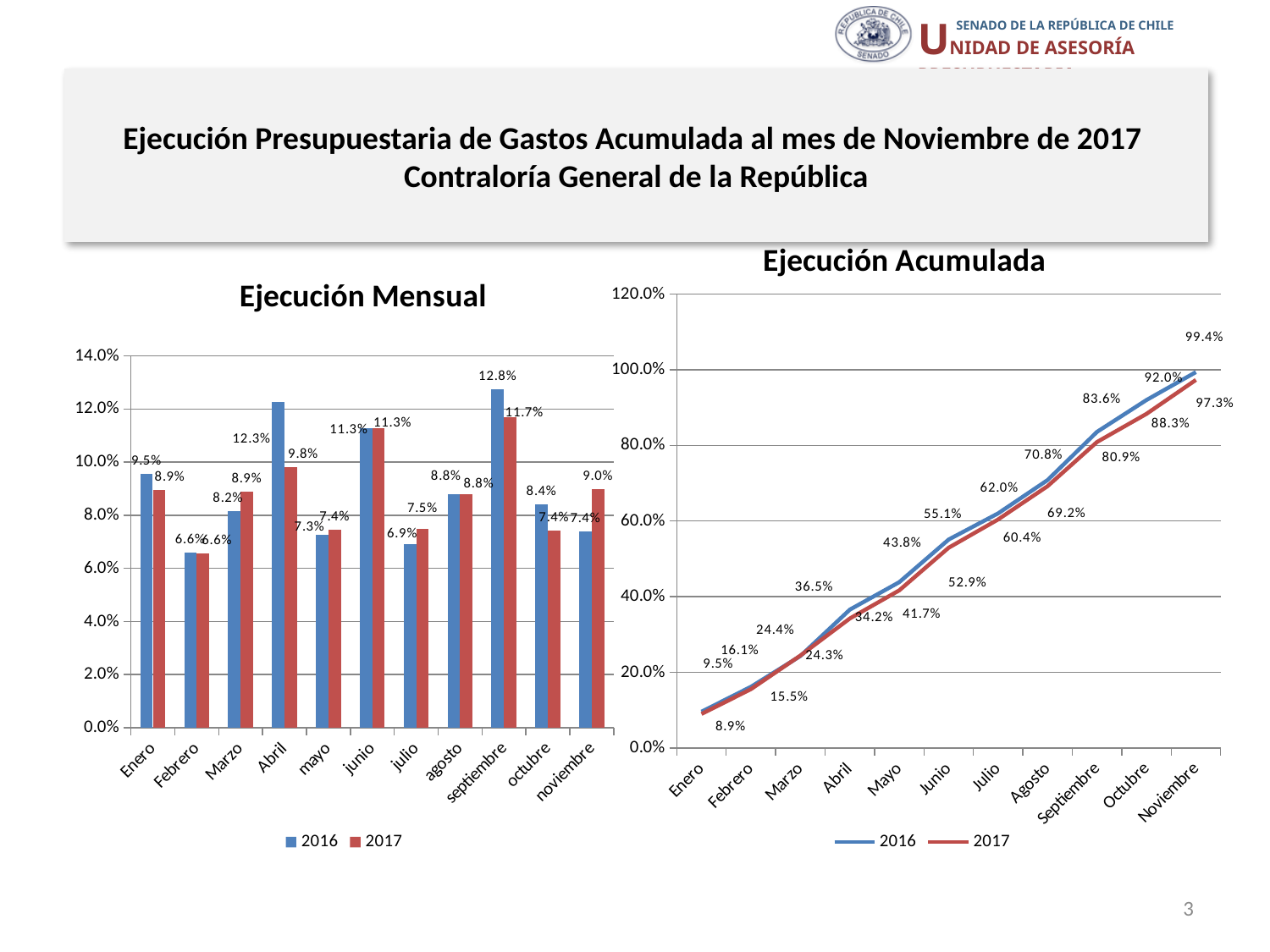
In the 'Ejecución Mensual' chart, what is the 2017 value for noviembre? 9.0% In the 'Ejecución Acumulada' chart, what is the difference between the 2016 and 2017 values for Octubre? 3.7% In the 'Ejecución Mensual' chart, which is larger for octubre, the 2016 value or the 2017 value? 2016 In the 'Ejecución Mensual' chart, what is the difference between the 2016 and 2017 values for septiembre? 1.1% What kind of chart is 'Ejecución Mensual'? Bar chart In the 'Ejecución Mensual' chart, which month has the lowest 2017 value? Febrero In the 'Ejecución Acumulada' chart, do the values rise or fall from Enero to Noviembre? Rise How many series does the legend of the 'Ejecución Acumulada' chart list? 2 In the 'Ejecución Mensual' chart, which month has the highest 2016 value? septiembre In the 'Ejecución Mensual' chart, what is the 2016 value for Abril? 12.3% In the 'Ejecución Acumulada' chart, what is the 2016 value for Junio? 55.1% In the 'Ejecución Acumulada' chart, what is the 2017 value for Noviembre? 97.3%